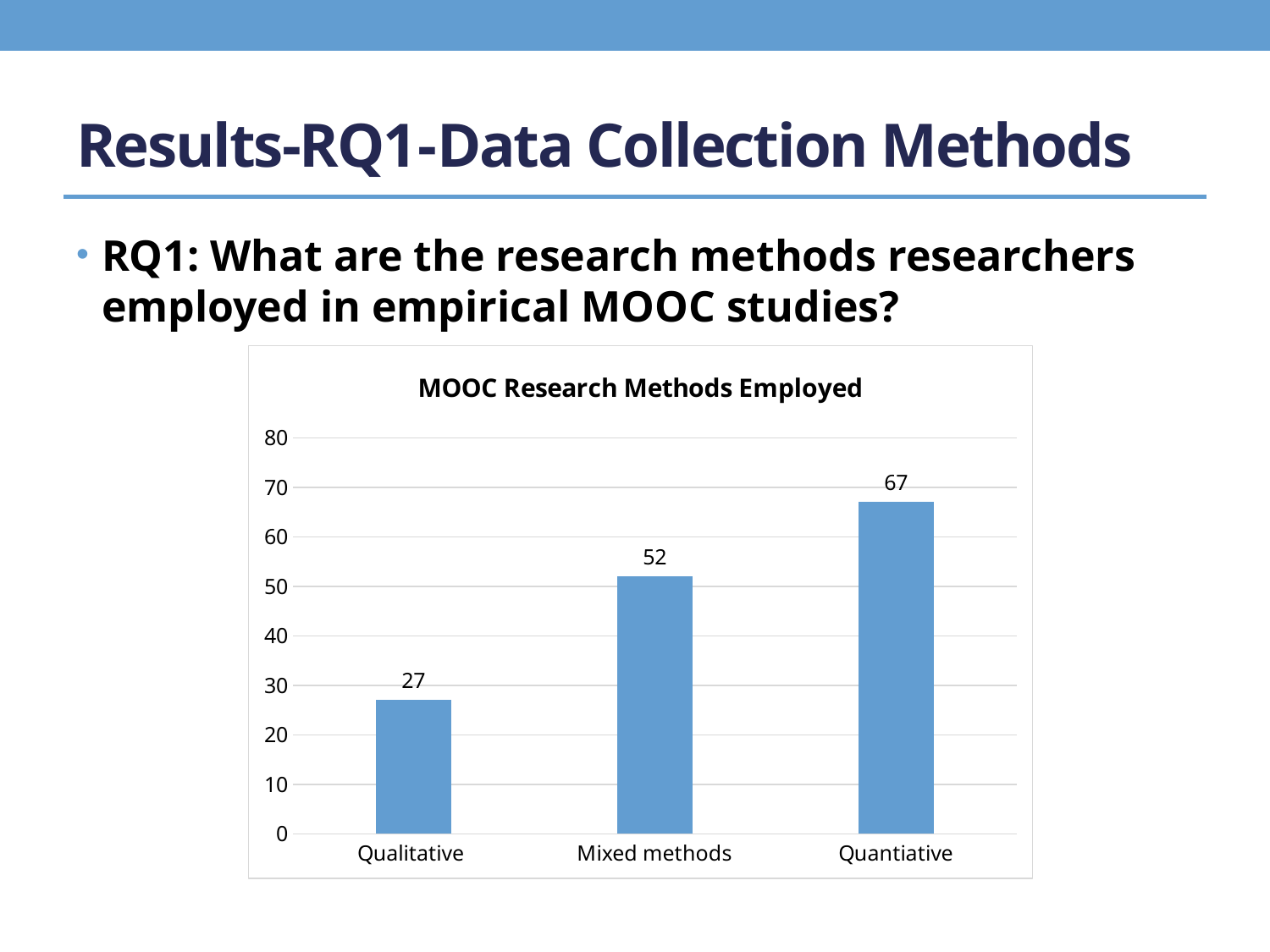
What is the difference between the values for Mixed methods and Qualitative? 25 What is the difference between the values for Quantiative and Qualitative? 40 What is the value for Quantiative? 67 Is the value for Mixed methods greater or less than 60? less Which is larger, the value for Mixed methods or the value for Qualitative? Mixed methods What is the value for Qualitative? 27 What is the title of the chart? MOOC Research Methods Employed Which research method has the highest value? Quantiative What is the value for Mixed methods? 52 What kind of chart is shown on the slide? bar chart Which research method has the lowest value? Qualitative How many categories are shown on the x axis? 3